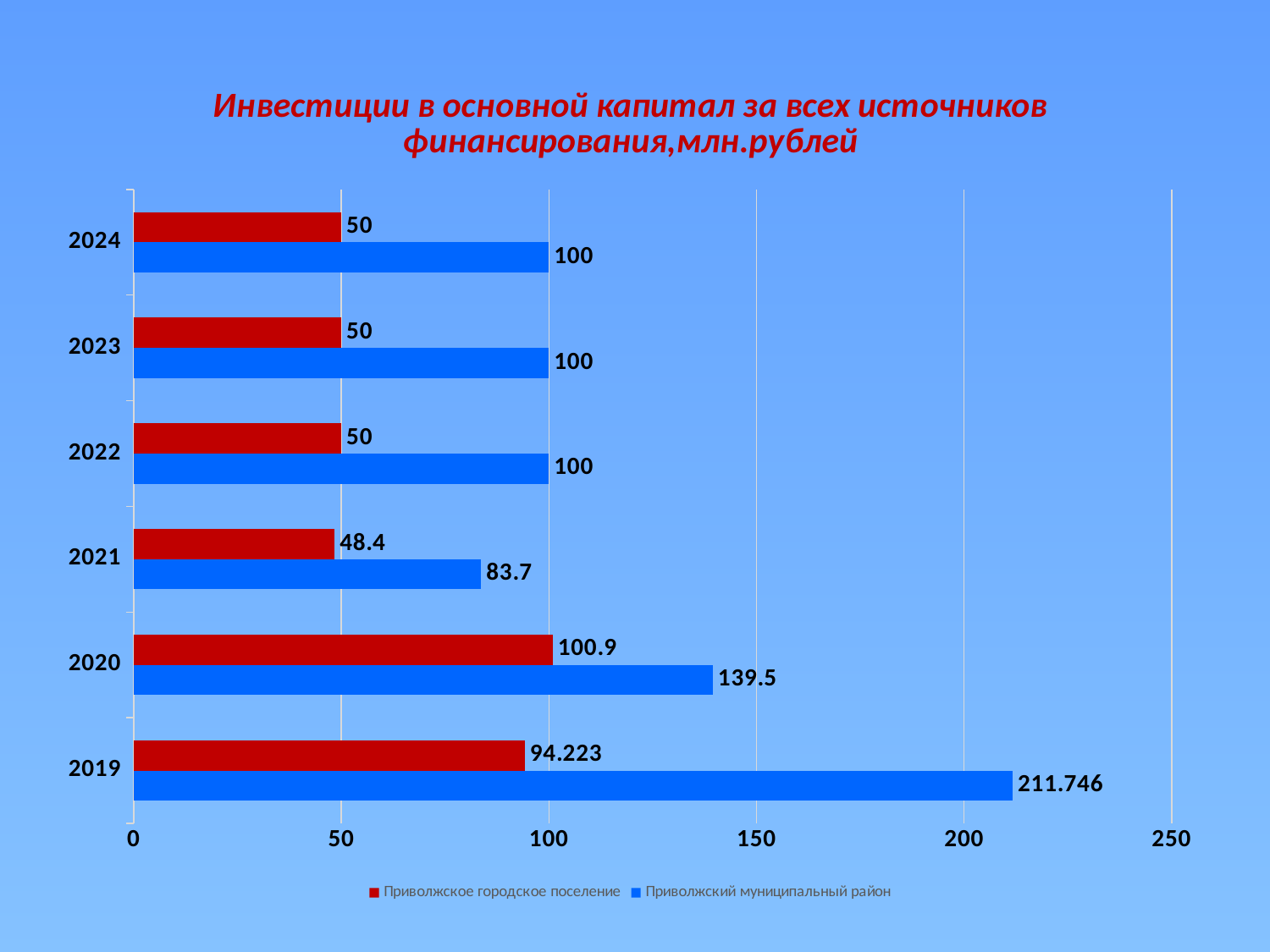
How many series does the legend list? 2 What is the value for Приволжское городское поселение in 2020? 100.9 Which year has the lowest value for Приволжское городское поселение? 2021 How many years are shown on the chart? 6 What is the difference between Приволжский муниципальный район and Приволжское городское поселение in 2020? 38.6 What is the value for Приволжский муниципальный район in 2021? 83.7 What kind of chart is shown on the slide? bar chart Which is larger in 2019: Приволжское городское поселение or Приволжский муниципальный район? Приволжский муниципальный район Which year has the highest value for Приволжский муниципальный район? 2019 What is the value for Приволжский муниципальный район in 2019? 211.746 What is the value for Приволжское городское поселение in 2021? 48.4 What colour are the bars for Приволжское городское поселение? red